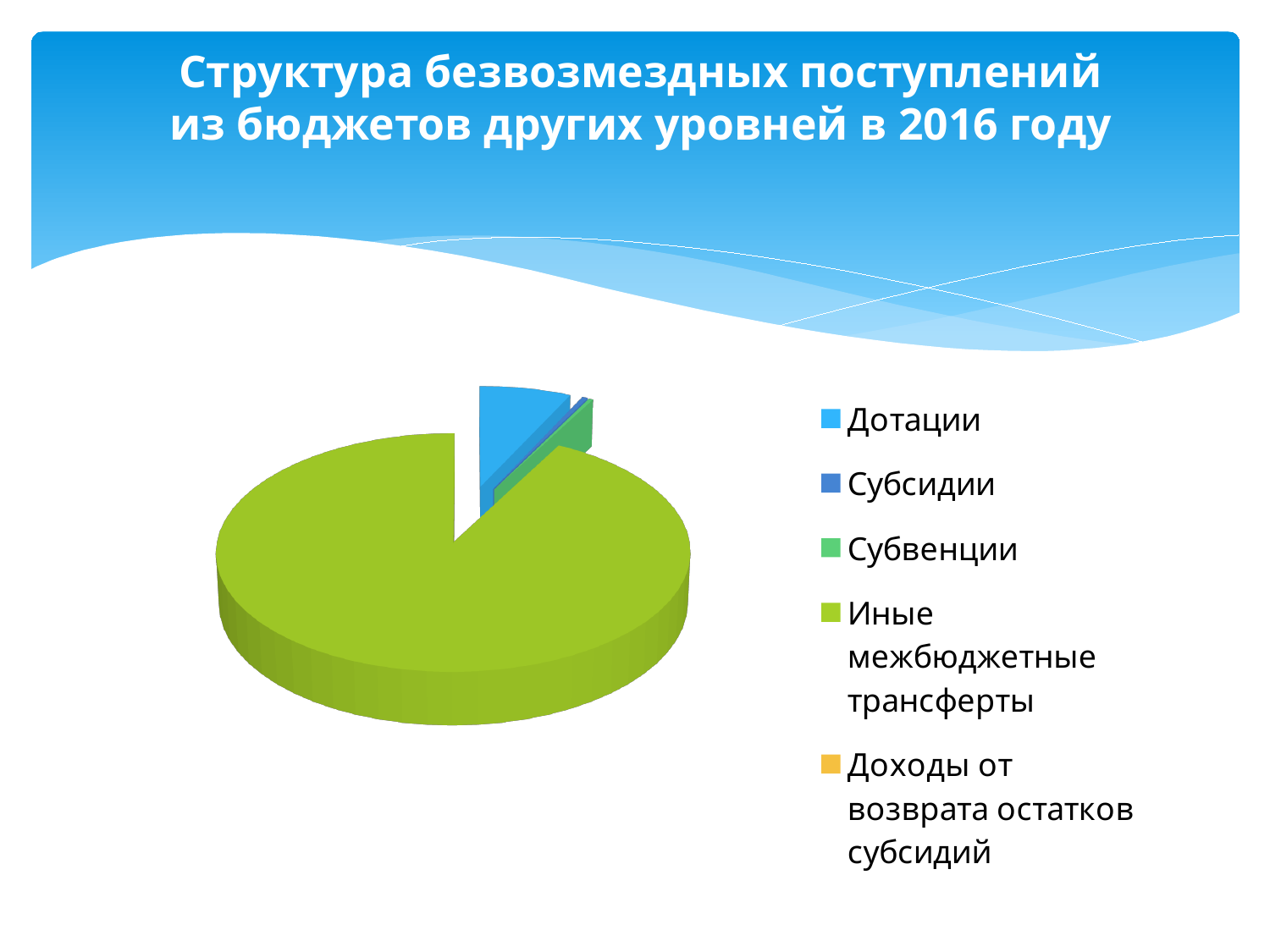
Which is larger in the pie chart: Дотации or Субсидии? Дотации Which legend entry is shown in orange? Доходы от возврата остатков субсидий What kind of chart is shown on the slide? Pie chart How many categories does the legend of the pie chart list? 5 Which is larger in the pie chart: Иные межбюджетные трансферты or Дотации? Иные межбюджетные трансферты Which colour represents Дотации in the pie chart? Light blue Which category has the largest slice of the pie chart? Иные межбюджетные трансферты Which year does the chart describe? 2016